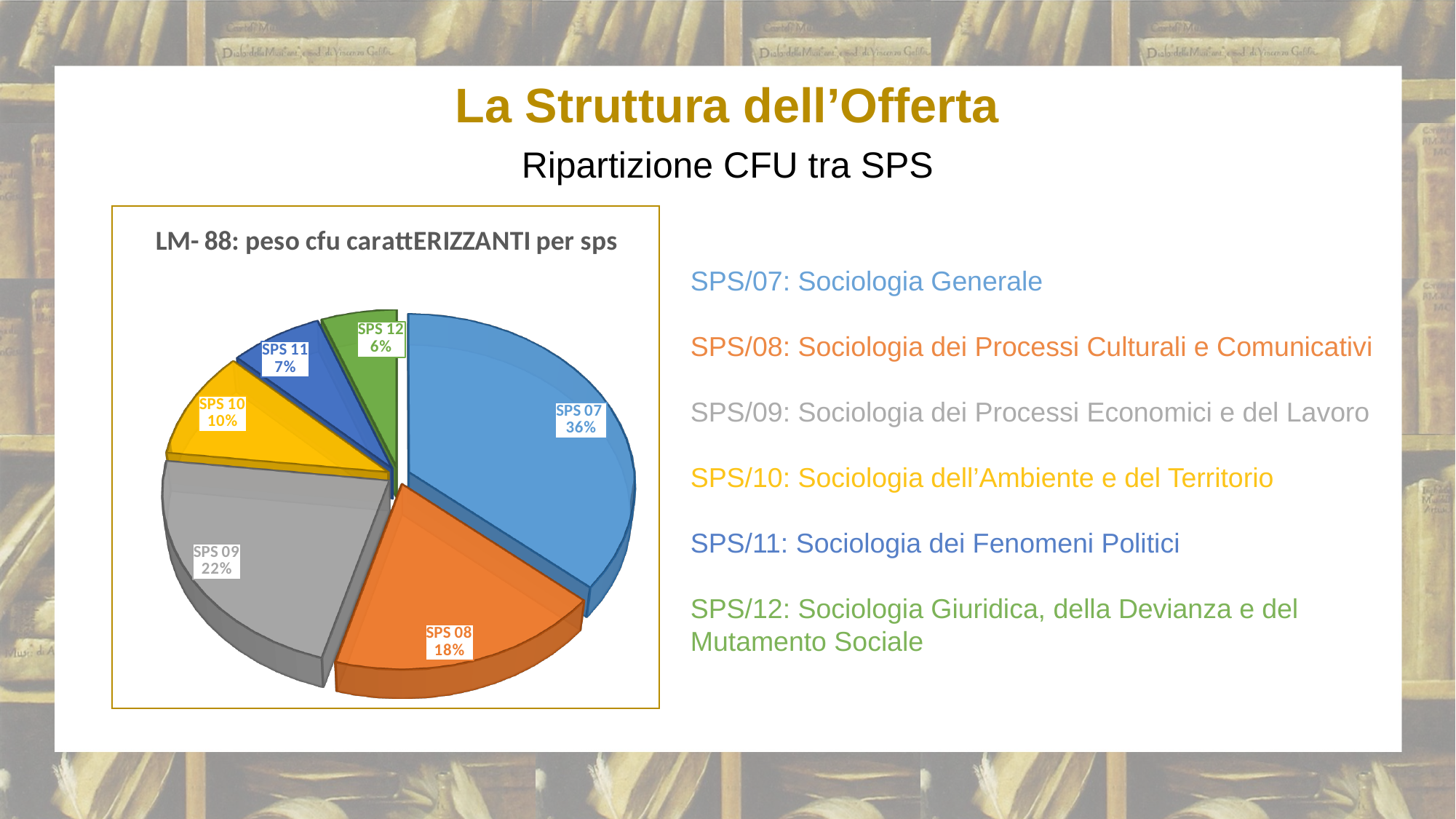
Which SPS has the smallest slice of the pie? SPS 12 What is the difference in percentage points between SPS 10 and SPS 11? 3 What colour is the SPS 08 slice? orange What share of the pie does SPS 12 have? 6% What is the difference in percentage points between SPS 07 and SPS 08? 18 Which is larger, the slice for SPS 09 or the slice for SPS 10? SPS 09 What share of the pie does SPS 07 have? 36% How many slices does the pie chart have? 6 What kind of chart is shown on the slide? pie chart Which SPS has the largest slice of the pie? SPS 07 What is the chart's title? LM- 88: peso cfu carattERIZZANTI per sps What share of the pie does SPS 09 have? 22%